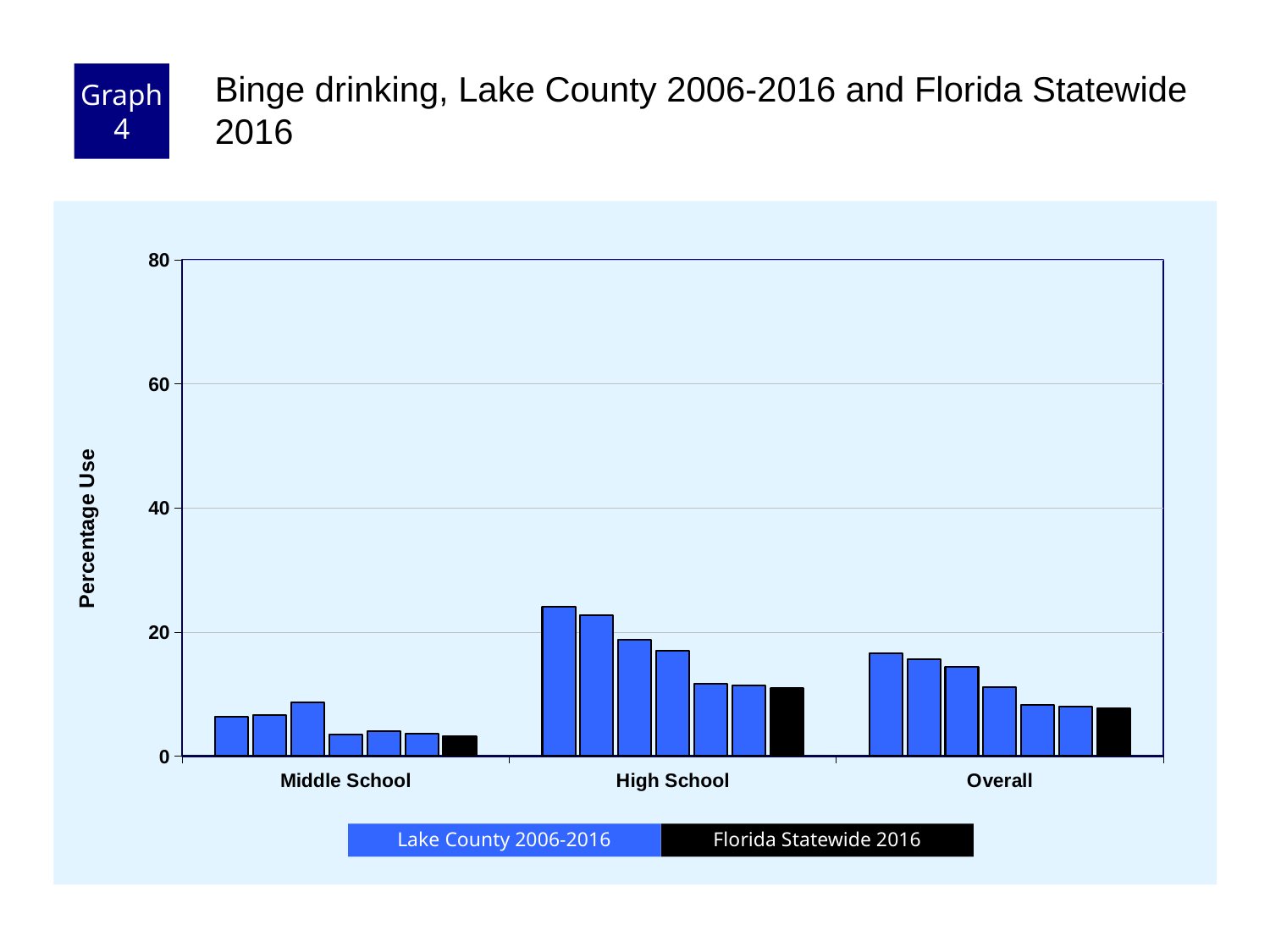
Do the Lake County 2006-2016 bars for High School rise or fall from left to right? fall Is the Florida Statewide 2016 value for Overall greater or less than 20? less How many categories are shown on the x axis? 3 Which category has the lowest bars overall? Middle School Is the value of the tallest Middle School bar greater or less than 20? less What kind of chart is shown on the slide? bar chart How many series does the legend list? 2 Is the value of the tallest High School bar greater or less than 20? greater What is the title of the y axis? Percentage Use Which is larger, the Florida Statewide 2016 bar for High School or the Florida Statewide 2016 bar for Middle School? High School Which category has the highest bars overall? High School Which colour represents Florida Statewide 2016 in the legend? black